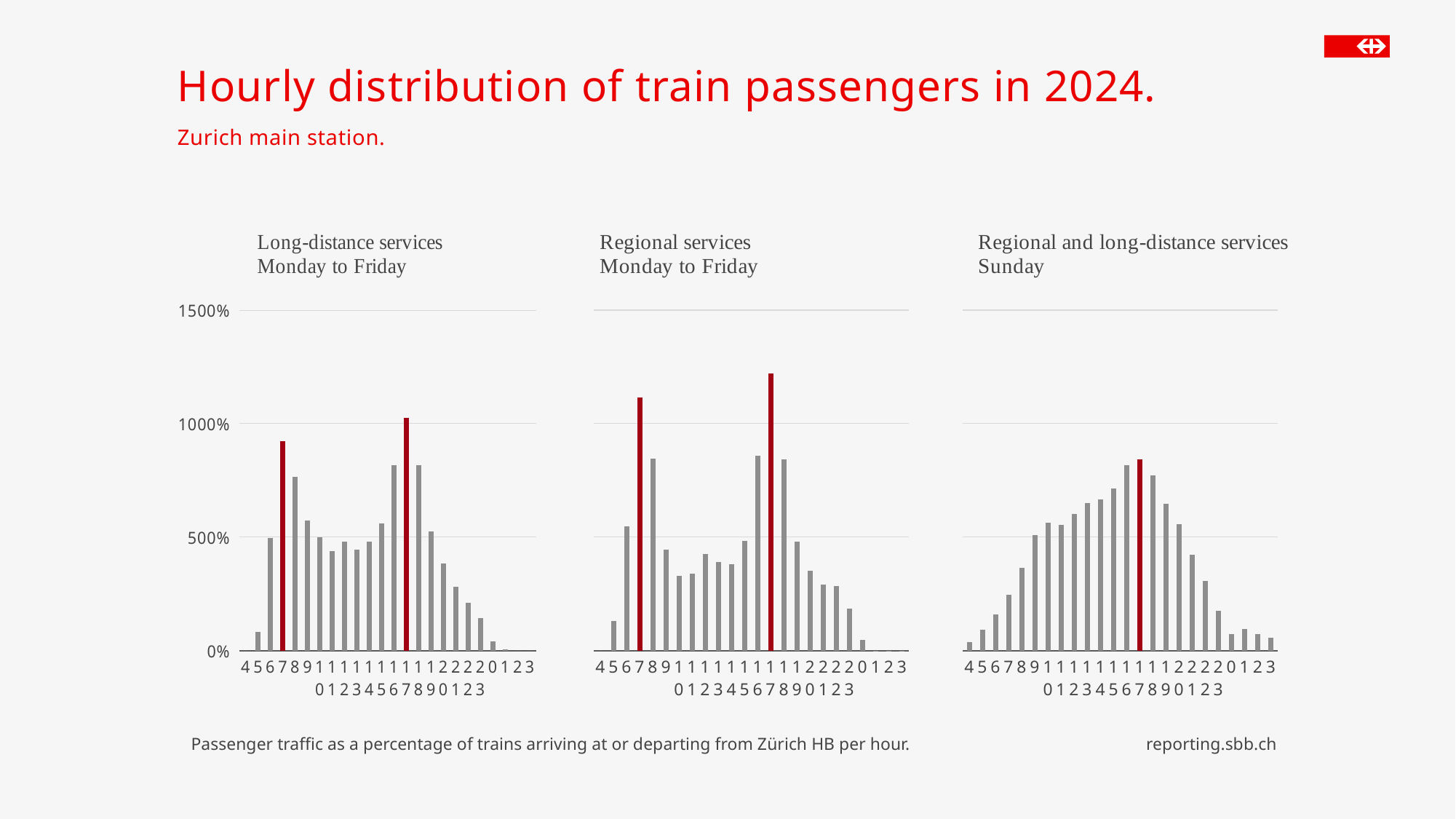
In the 'Long-distance services Monday to Friday' chart, which hours are highlighted with red bars? 7 and 17 In the 'Regional services Monday to Friday' chart, how many hourly bars are plotted? 24 In the 'Regional services Monday to Friday' chart, which is larger, the value for hour 7 or the value for hour 16? hour 7 In the 'Regional and long-distance services Sunday' chart, do the values rise or fall from hour 4 to hour 17? rise What kind of chart is the 'Long-distance services Monday to Friday' chart? bar chart In the 'Long-distance services Monday to Friday' chart, is the value for hour 7 greater or less than 1000%? less In the 'Regional services Monday to Friday' chart, which hour has the highest value? 17 In the 'Long-distance services Monday to Friday' chart, which hour has the highest value? 17 In the 'Regional services Monday to Friday' chart, is the value for hour 17 greater or less than 1000%? greater In the 'Regional and long-distance services Sunday' chart, is the value for hour 17 greater or less than 1000%? less How many charts are shown on the slide? 3